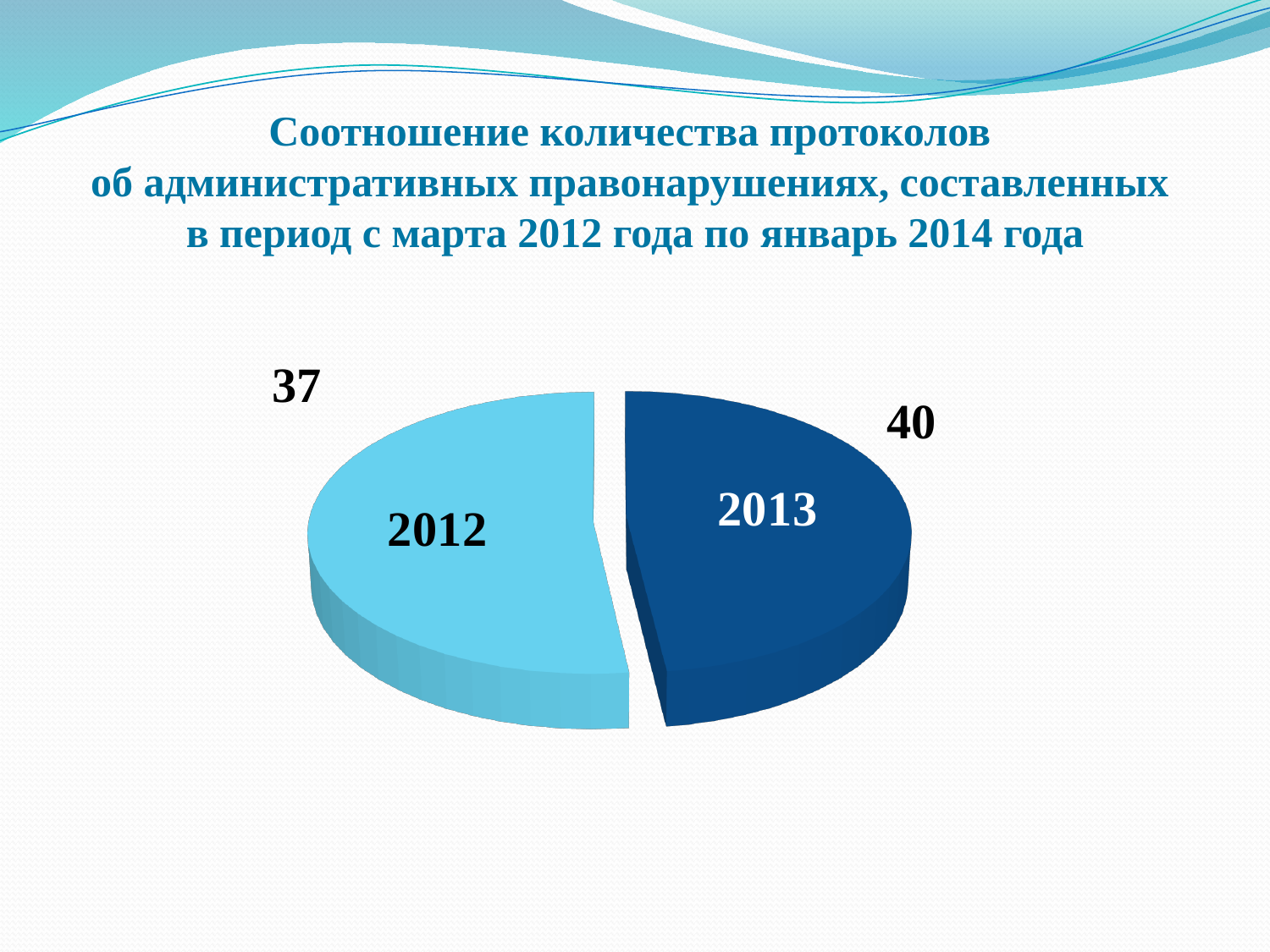
What is the difference between the values for 2013 and 2012? 3 What is the value for 2012? 37 What is the value for 2013? 40 Is the value for 2012 larger or smaller than the value for 2013? smaller Which year has the larger value? 2013 What is the total of the two slices? 77 What kind of chart is shown on the slide? pie chart Which year has the smaller value? 2012 Which slice is shown in dark blue? 2013 Which slice is shown in light blue? 2012 How many slices does the pie chart have? 2